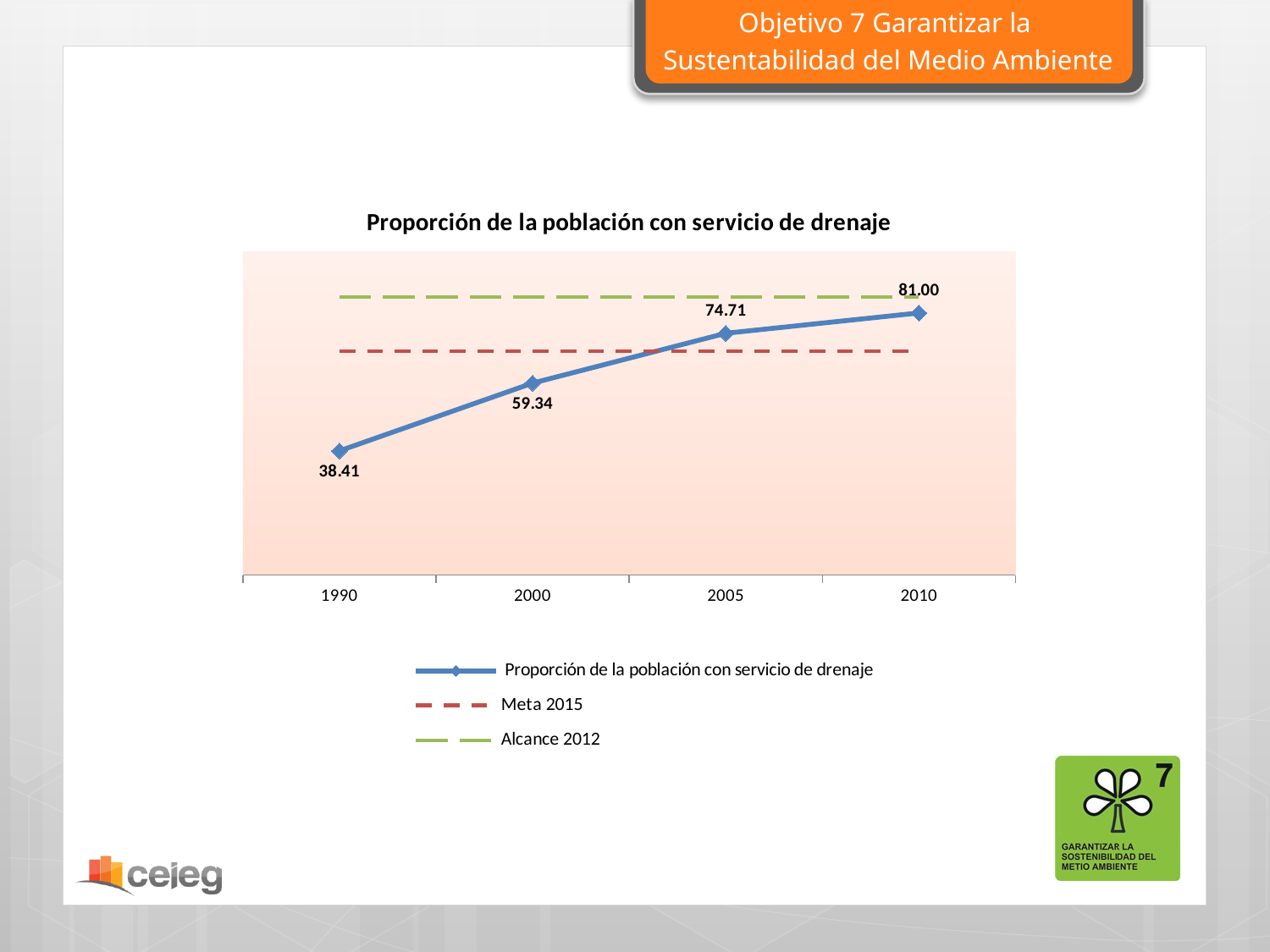
Does the proportion of the population with drainage service rise or fall from 1990 to 2010? Rise What is the value of the proportion of the population with drainage service in 2005? 74.71 Which year has a larger value, 2000 or 2005? 2005 What is the value of the proportion of the population with drainage service in 2000? 59.34 In which year is the proportion of the population with drainage service lowest? 1990 What is the value of the proportion of the population with drainage service in 1990? 38.41 In which year is the proportion of the population with drainage service highest? 2010 What is the value of the proportion of the population with drainage service in 2010? 81.00 What is the title of the chart? Proporción de la población con servicio de drenaje What is the difference between the 2010 value and the 1990 value of the proportion of the population with drainage service? 42.59 How many series does the legend list? 3 What type of chart is shown on the slide? Line chart